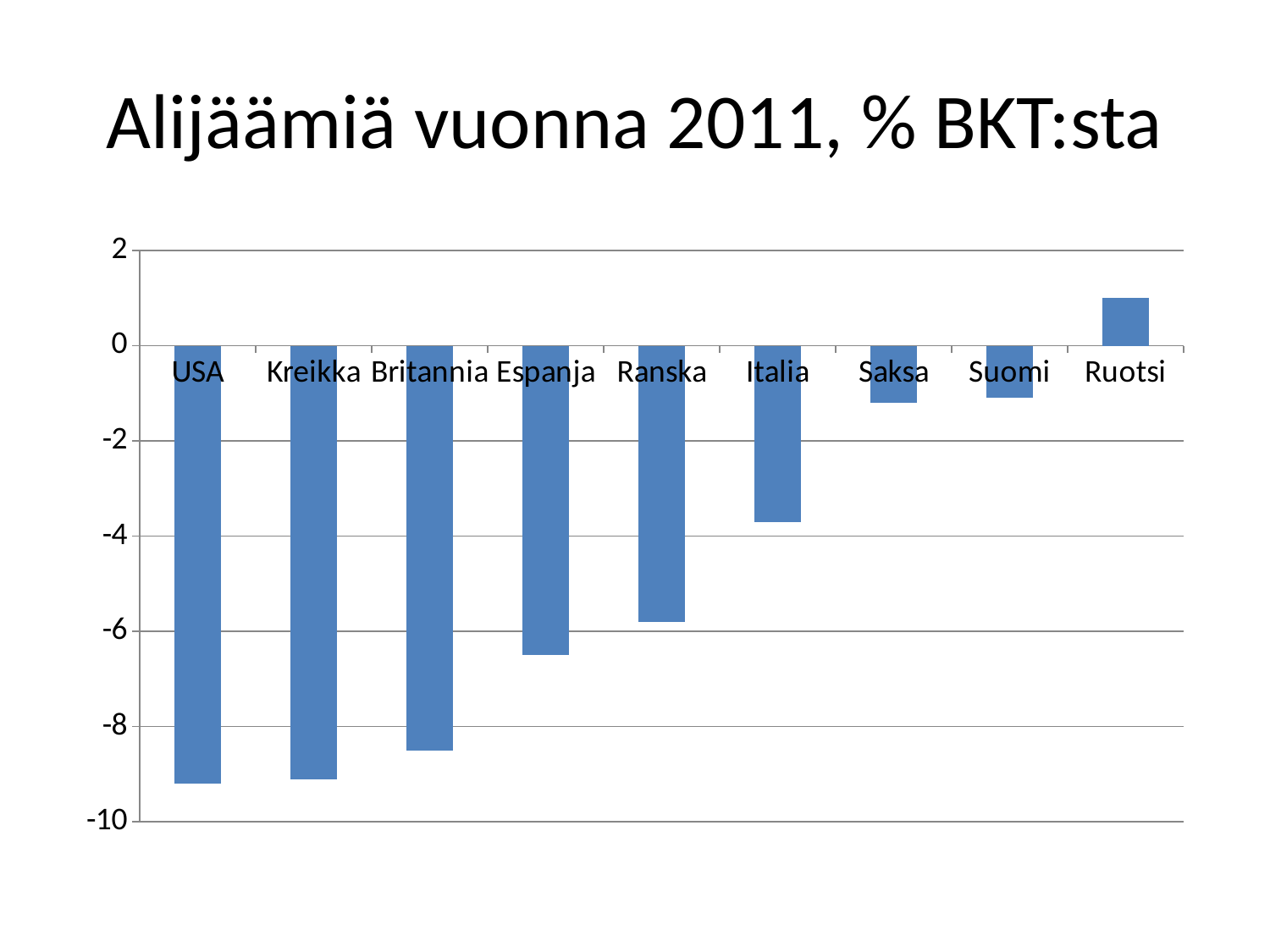
Is the value for Ranska greater or less than -6? greater Is the value for Britannia greater or less than -8? less Do the values generally rise or fall moving from left to right along the x axis? rise Which country has the highest value in the chart? Ruotsi Which has the larger value, Espanja or Britannia? Espanja Is the value for Italia greater or less than -4? greater Which has the larger value, Italia or Ranska? Italia What kind of chart is shown on the slide? bar chart How many countries are shown on the x axis of the chart? 9 What is the title of the chart? Alijäämiä vuonna 2011, % BKT:sta